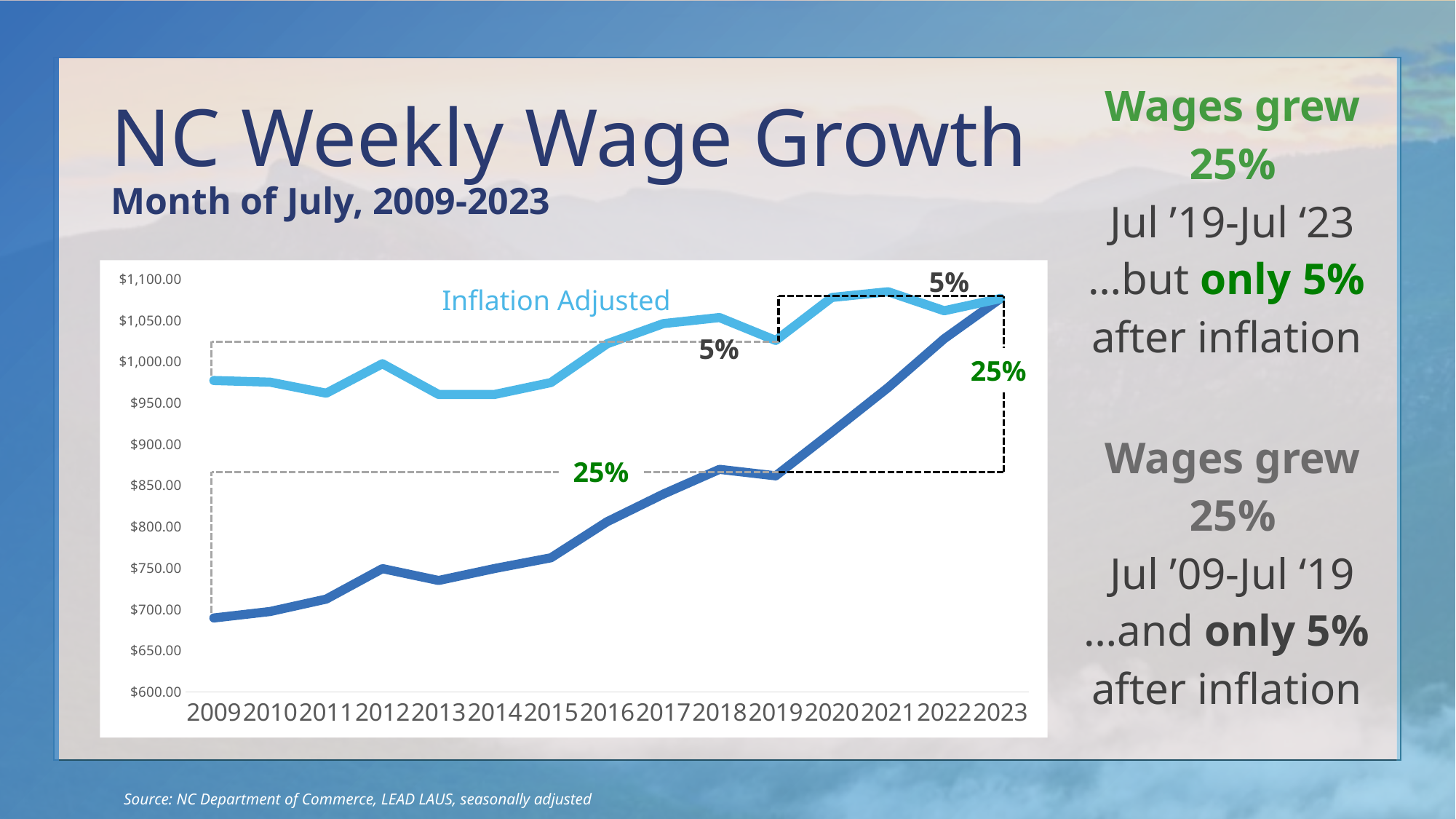
Is the dark blue line's value for 2009 greater or less than $750? less Does the dark blue (non-inflation-adjusted) line generally rise or fall from 2009 to 2023? rise Is the dark blue line's value for 2023 greater or less than $1,050? greater What is the title of the chart on the slide? NC Weekly Wage Growth In which year is the dark blue (non-inflation-adjusted) line at its lowest? 2009 Is the Inflation Adjusted value for 2013 greater or less than $1,000? less How many years are shown along the x axis of the chart? 15 In 2009, which is higher: the Inflation Adjusted line or the dark blue line? Inflation Adjusted What kind of chart is shown on the slide? line chart Which series is labelled directly on the chart in light blue? Inflation Adjusted